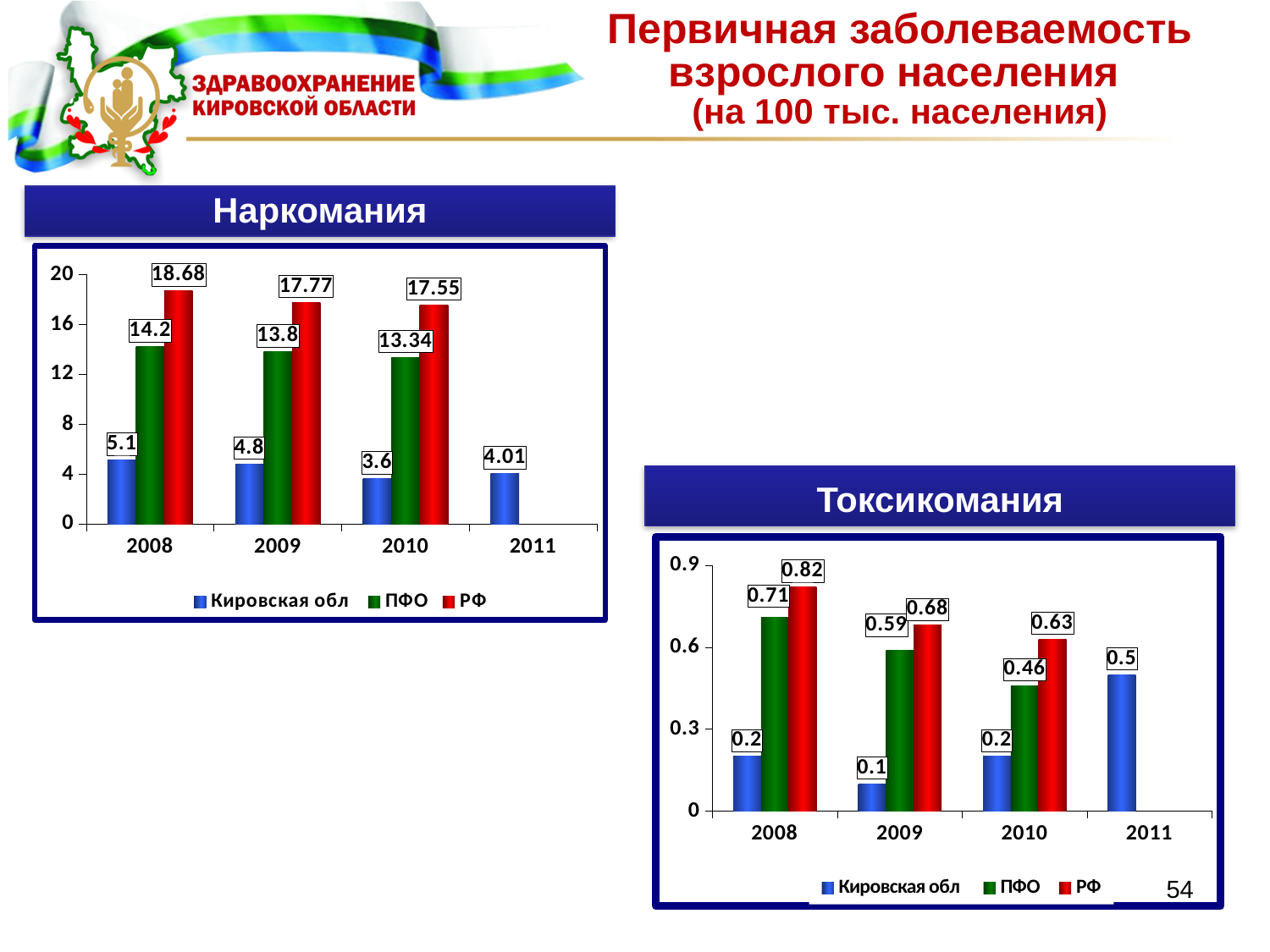
In the Наркомания chart, which year has the highest value for РФ? 2008 In the Токсикомания chart, what is the value for Кировская обл in 2011? 0.5 In the Наркомания chart, what is the value for РФ in 2008? 18.68 In the Токсикомания chart, what is the value for ПФО in 2009? 0.59 What type of chart is the Токсикомания chart? bar chart In the Наркомания chart, what is the difference between the РФ and ПФО values in 2009? 3.97 In the Токсикомания chart, how many years are shown on the x axis? 4 In the Наркомания chart, what is the value for ПФО in 2010? 13.34 In the Наркомания chart, what is the value for Кировская обл in 2011? 4.01 In the Наркомания chart, how many series does the legend list? 3 In the Токсикомания chart, which year has the lowest value for Кировская обл? 2009 In the Токсикомания chart, is the value for РФ in 2010 larger or smaller than the value for ПФО in 2008? smaller